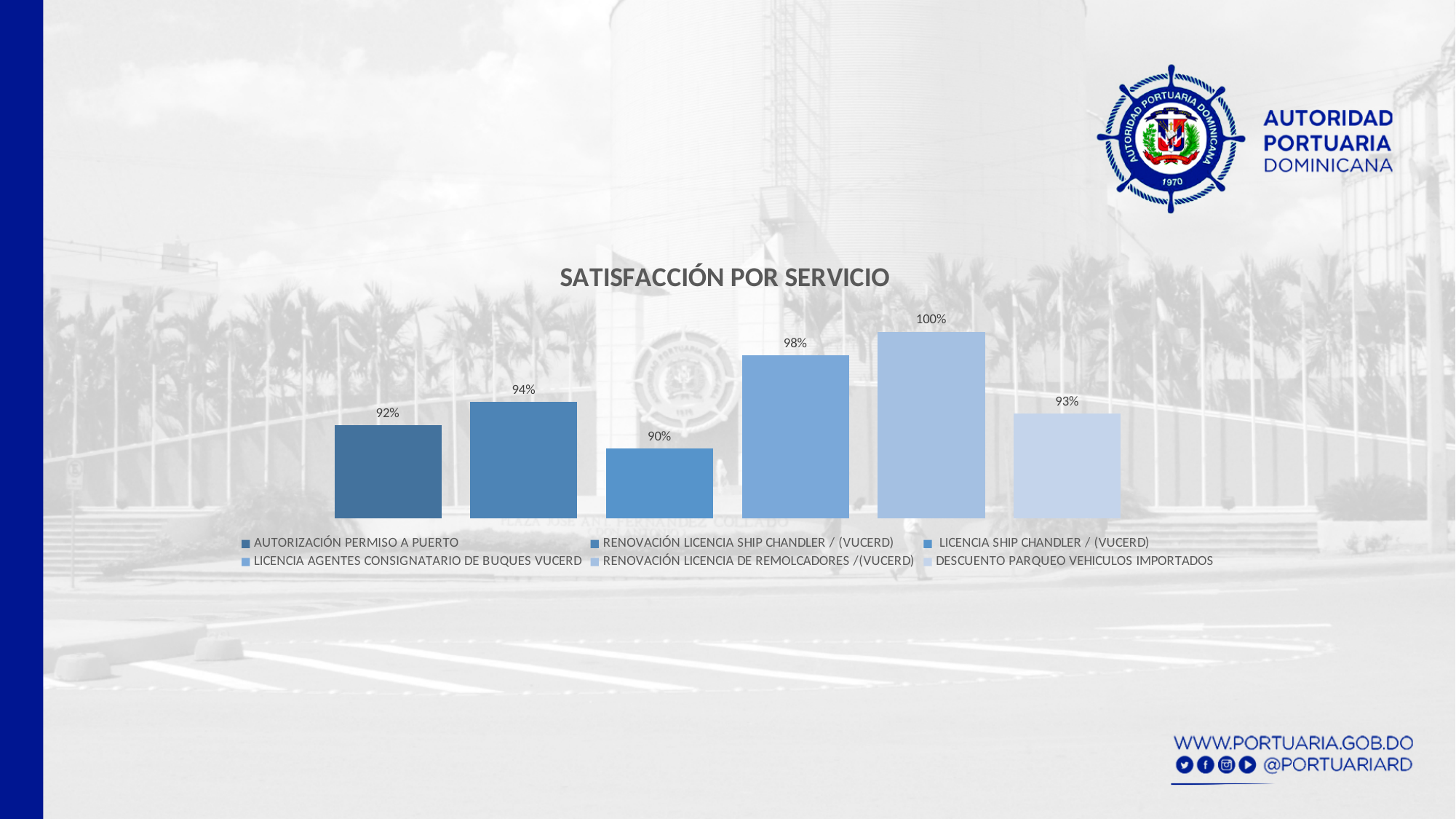
What is the title of the chart? SATISFACCIÓN POR SERVICIO How many bars are shown in the chart? 6 What is the satisfaction value for AUTORIZACIÓN PERMISO A PUERTO? 92% What is the satisfaction value for DESCUENTO PARQUEO VEHICULOS IMPORTADOS? 93% Which has a higher satisfaction value, RENOVACIÓN LICENCIA SHIP CHANDLER / (VUCERD) or DESCUENTO PARQUEO VEHICULOS IMPORTADOS? RENOVACIÓN LICENCIA SHIP CHANDLER / (VUCERD) Which service has the lowest satisfaction value? LICENCIA SHIP CHANDLER / (VUCERD) How many entries does the legend list? 6 What kind of chart is shown on the slide? Bar chart What is the satisfaction value for RENOVACIÓN LICENCIA DE REMOLCADORES /(VUCERD)? 100% Which service has the highest satisfaction value? RENOVACIÓN LICENCIA DE REMOLCADORES /(VUCERD) What is the satisfaction value for LICENCIA SHIP CHANDLER / (VUCERD)? 90% What is the difference between the satisfaction values for LICENCIA AGENTES CONSIGNATARIO DE BUQUES VUCERD and AUTORIZACIÓN PERMISO A PUERTO? 6%